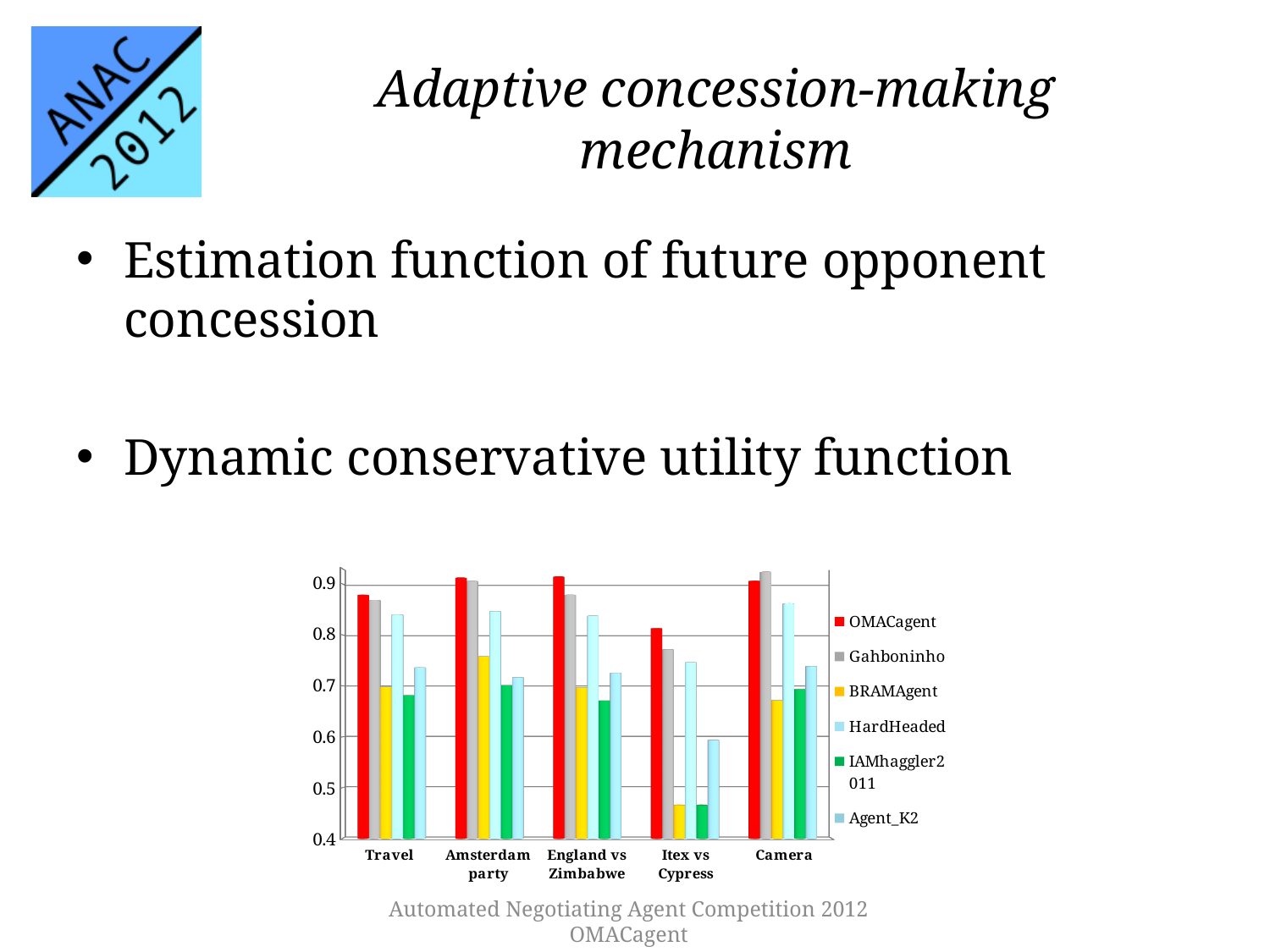
Which series has the highest value in the England vs Zimbabwe category? OMACagent Is the value for HardHeaded in the Camera category greater or less than 0.8? greater What kind of chart is shown on the slide? bar chart What colour are the OMACagent bars in the chart? red In which category does OMACagent have its lowest value? Itex vs Cypress Is the value for IAMhaggler2011 in the Travel category greater or less than 0.7? less Is the value for BRAMAgent in the Amsterdam party category greater or less than 0.7? greater In the Travel category, which is larger: the value for OMACagent or the value for BRAMAgent? OMACagent How many categories are shown on the x axis of the chart? 5 How many series does the chart's legend list? 6